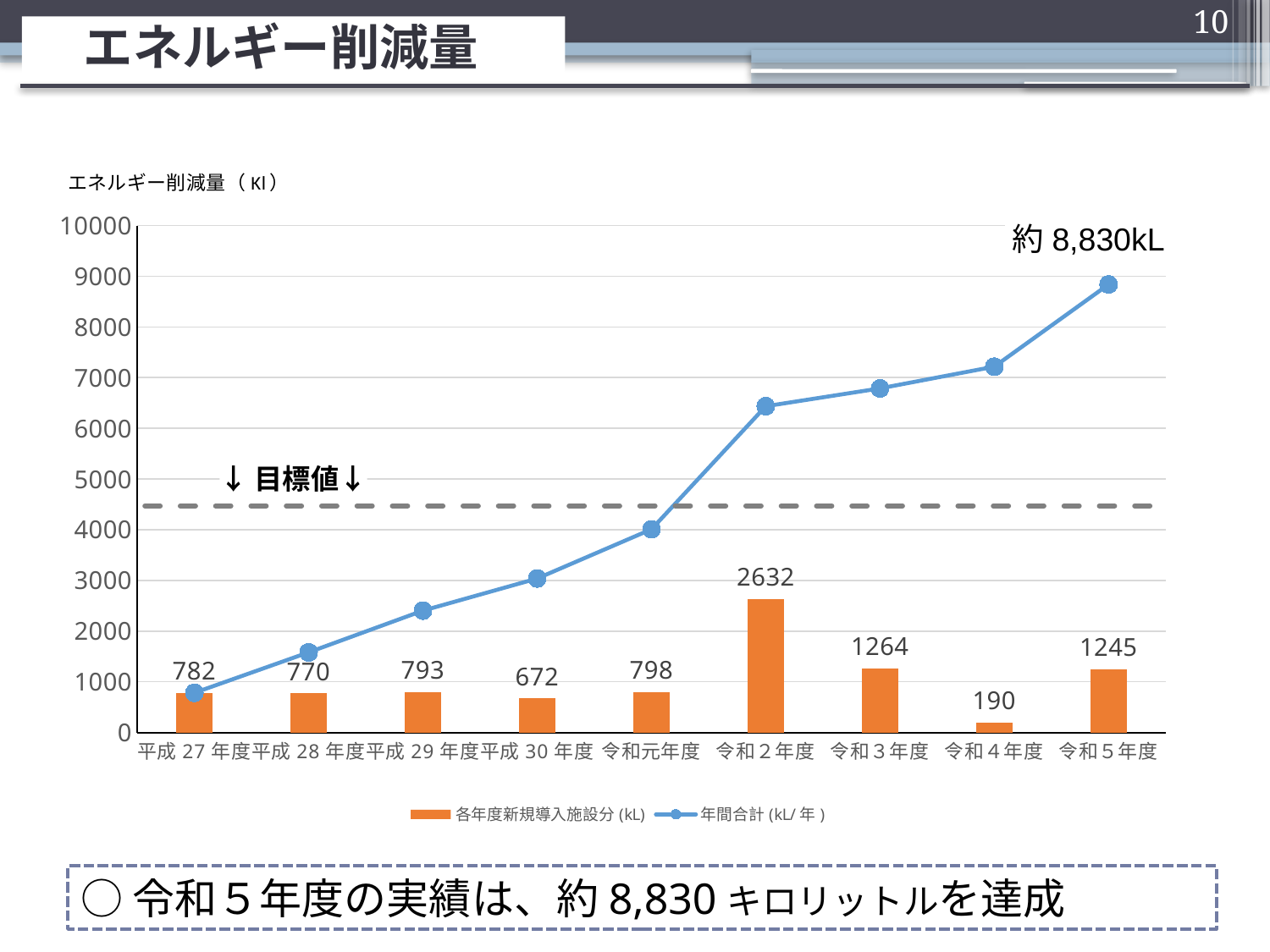
Is the 年間合計 (kL/年) value for 平成 29 年度 greater or less than 3000? less What is the value of the 各年度新規導入施設分 (kL) bar for 平成 30 年度? 672 How many series does the chart legend list? 2 Which is larger, the 各年度新規導入施設分 (kL) bar for 平成 27 年度 or for 令和元年度? 令和元年度 What is the value of the 各年度新規導入施設分 (kL) bar for 令和４年度? 190 How many years are shown on the x axis of the chart? 9 What is the difference between the 各年度新規導入施設分 (kL) bars for 令和３年度 and 令和５年度? 19 Does the 年間合計 (kL/年) line rise or fall from 平成 27 年度 to 令和５年度? rise Which year has the lowest 各年度新規導入施設分 (kL) bar? 令和４年度 Which year has the highest 各年度新規導入施設分 (kL) bar? 令和２年度 Is the 年間合計 (kL/年) value for 令和２年度 greater or less than 6000? greater What is the value of the 各年度新規導入施設分 (kL) bar for 令和２年度? 2632